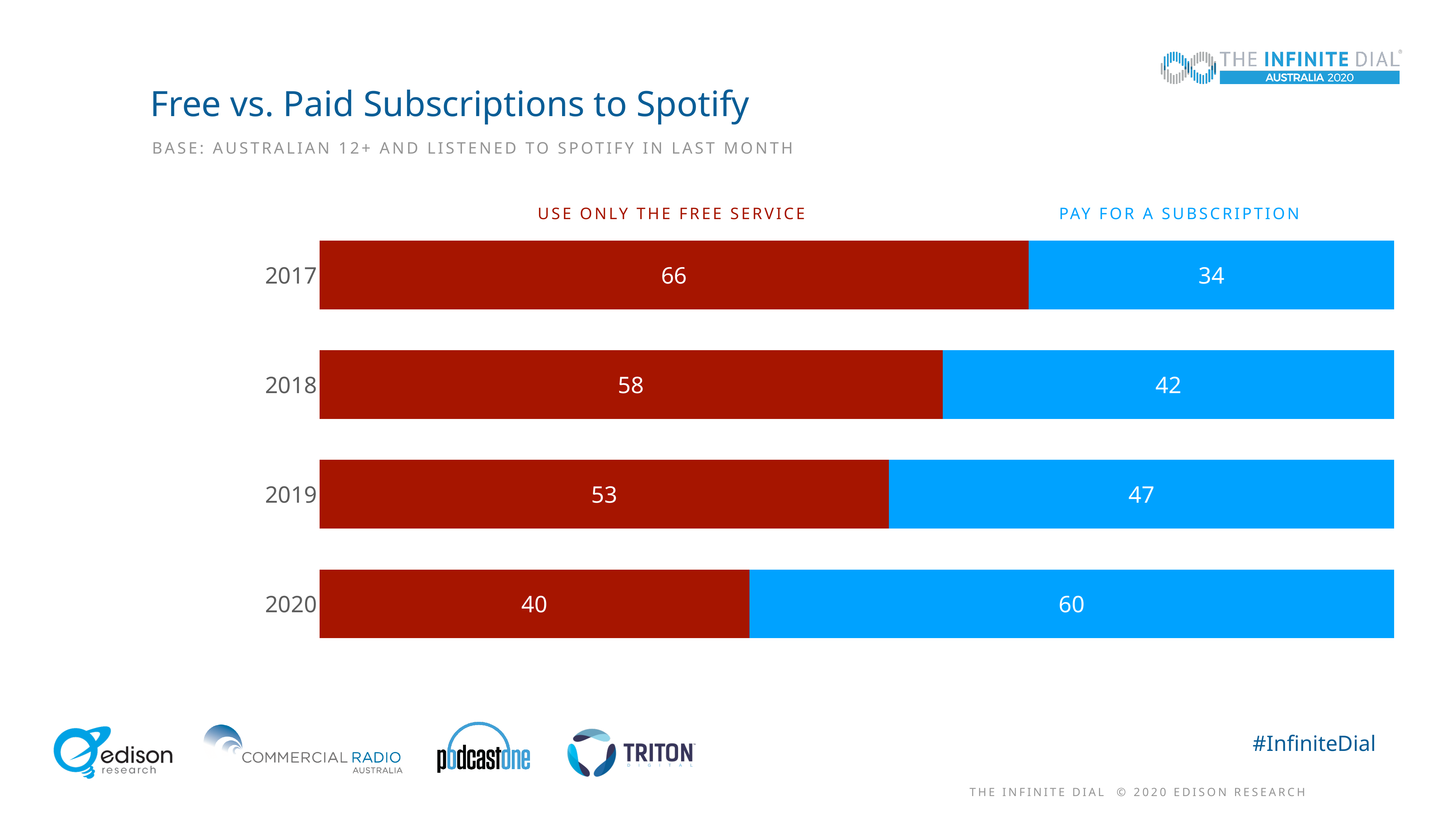
How many years are shown on the chart? 4 In which year is the 'Pay for a subscription' value highest? 2020 Does the 'Pay for a subscription' value rise or fall from 2017 to 2020? Rise What kind of chart is shown on the slide? Stacked bar chart What is the difference between the 'Use only the free service' values for 2017 and 2020? 26 In 2018, which is larger: 'Use only the free service' or 'Pay for a subscription'? Use only the free service What is the value for 'Pay for a subscription' in 2020? 60 What is the total of the stacked bar for 2019? 100 What is the value for 'Use only the free service' in 2019? 53 How many series does the chart show? 2 What percentage of Spotify listeners used only the free service in 2017? 66 In which year is the 'Use only the free service' value lowest? 2020